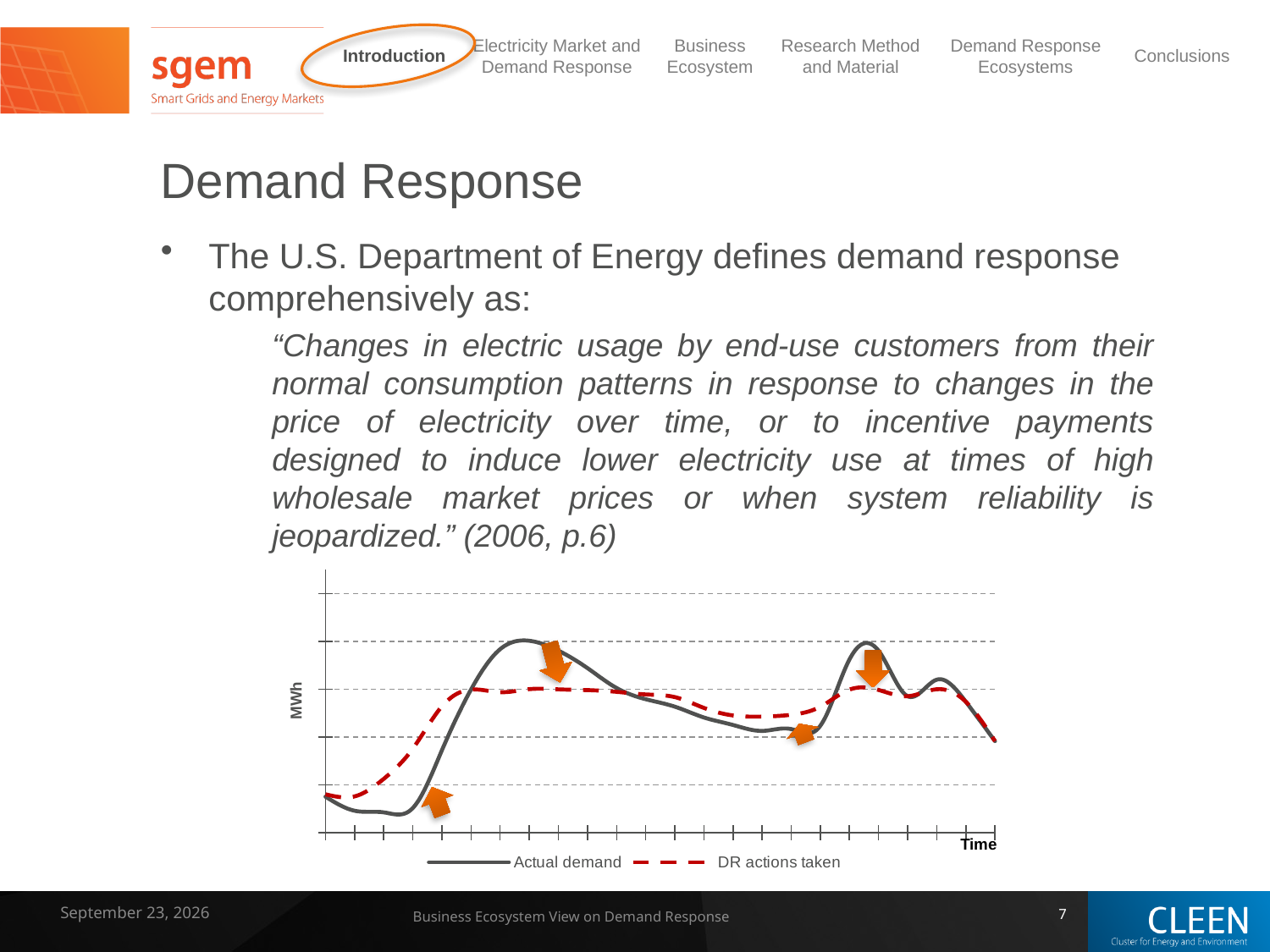
Which series shows the larger swings between its highest and lowest values, Actual demand or DR actions taken? Actual demand What are the two series named in the chart's legend? Actual demand and DR actions taken What kind of chart is shown on the slide? Line chart Which series reaches the higher peak, Actual demand or DR actions taken? Actual demand Which series drops to the lower minimum, Actual demand or DR actions taken? Actual demand What is the label on the vertical axis of the chart? MWh How many series does the chart's legend list? 2